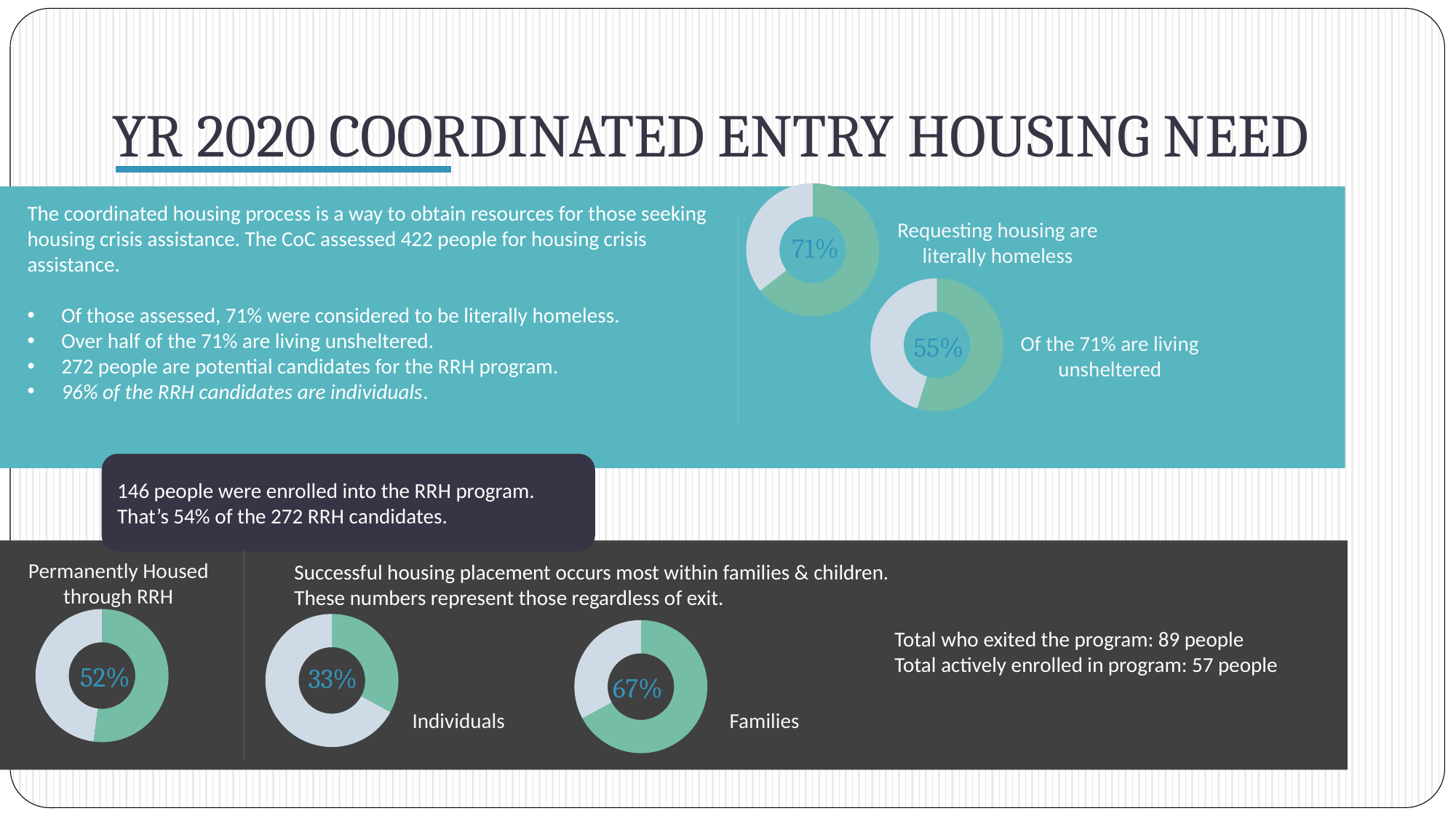
In the "Permanently Housed through RRH" donut chart at the bottom left, what percentage is shown? 52% In the bottom section, what percentage is shown in the donut chart labelled "Families"? 67% What kind of chart is used to show the 71% value at the top right of the slide? Donut chart Which of the two donut charts in the teal section at the top shows the larger percentage? Requesting housing are literally homeless (71%) In the bottom section, which donut chart shows the larger percentage, "Individuals" or "Families"? Families In the bottom section, what is the difference between the "Families" percentage and the "Individuals" percentage? 34% What is the title of the slide containing these donut charts? YR 2020 COORDINATED ENTRY HOUSING NEED In the donut chart labelled "Requesting housing are literally homeless", what percentage is shown? 71% How many donut charts are shown on the slide? 5 In the donut chart labelled "Of the 71% are living unsheltered", what percentage is shown? 55% Is the value in the "Permanently Housed through RRH" donut chart greater or less than 50%? greater In the bottom section, what percentage is shown in the donut chart labelled "Individuals"? 33%